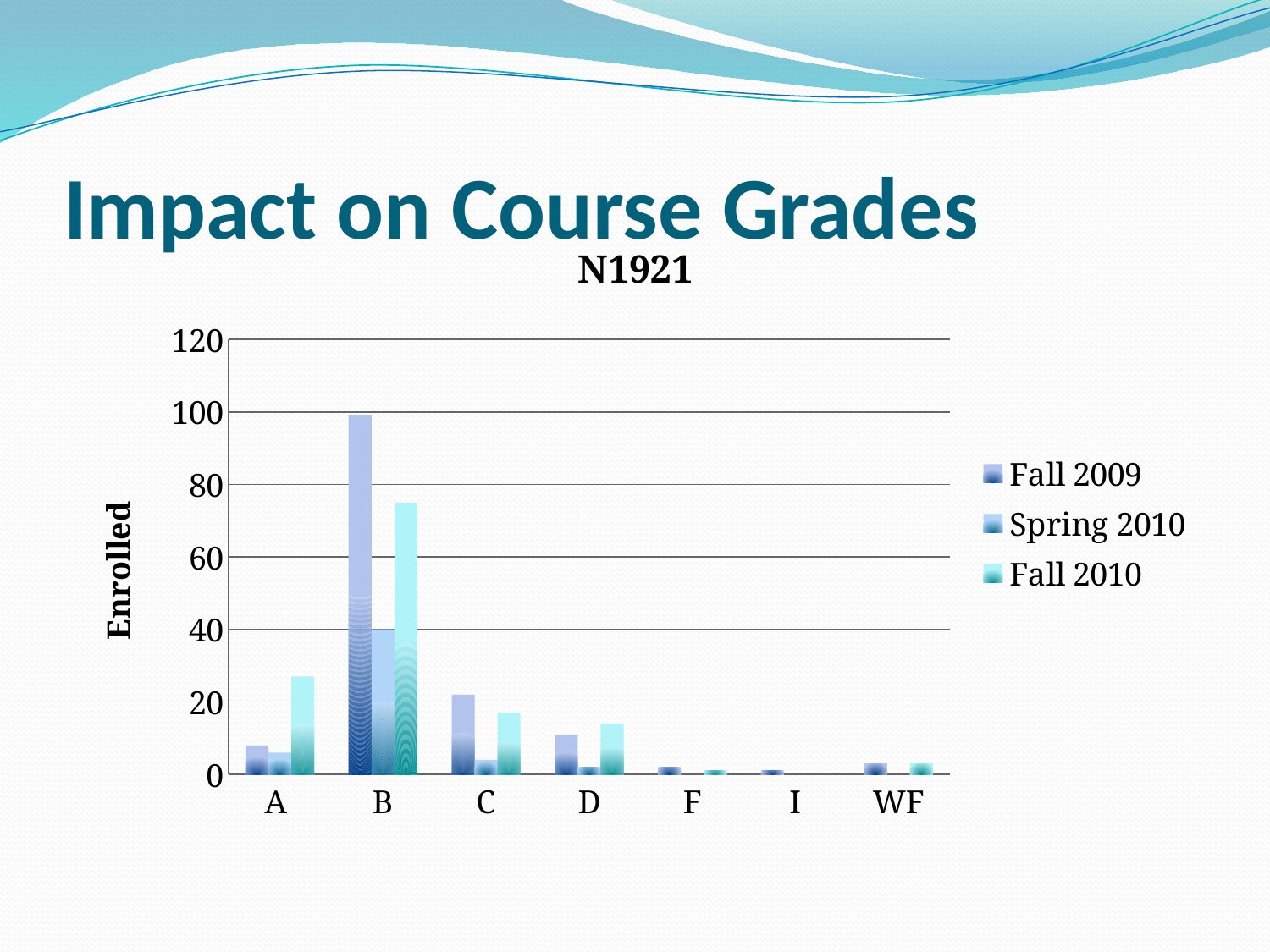
For grade A, which is larger: the Fall 2009 value or the Fall 2010 value? Fall 2010 What kind of chart is shown on the slide? bar chart Is the Fall 2010 value for grade B greater or less than 60? greater How many series does the legend list? 3 Which grade has the highest Fall 2009 value? B What is the label on the vertical axis of the chart? Enrolled How many grade categories are shown on the x axis? 7 Which grade has the highest Fall 2010 value? B For grade B, which is larger: the Fall 2009 value or the Spring 2010 value? Fall 2009 Is the Fall 2009 value for grade B greater or less than 80? greater Is the Fall 2010 value for grade A greater or less than 20? greater